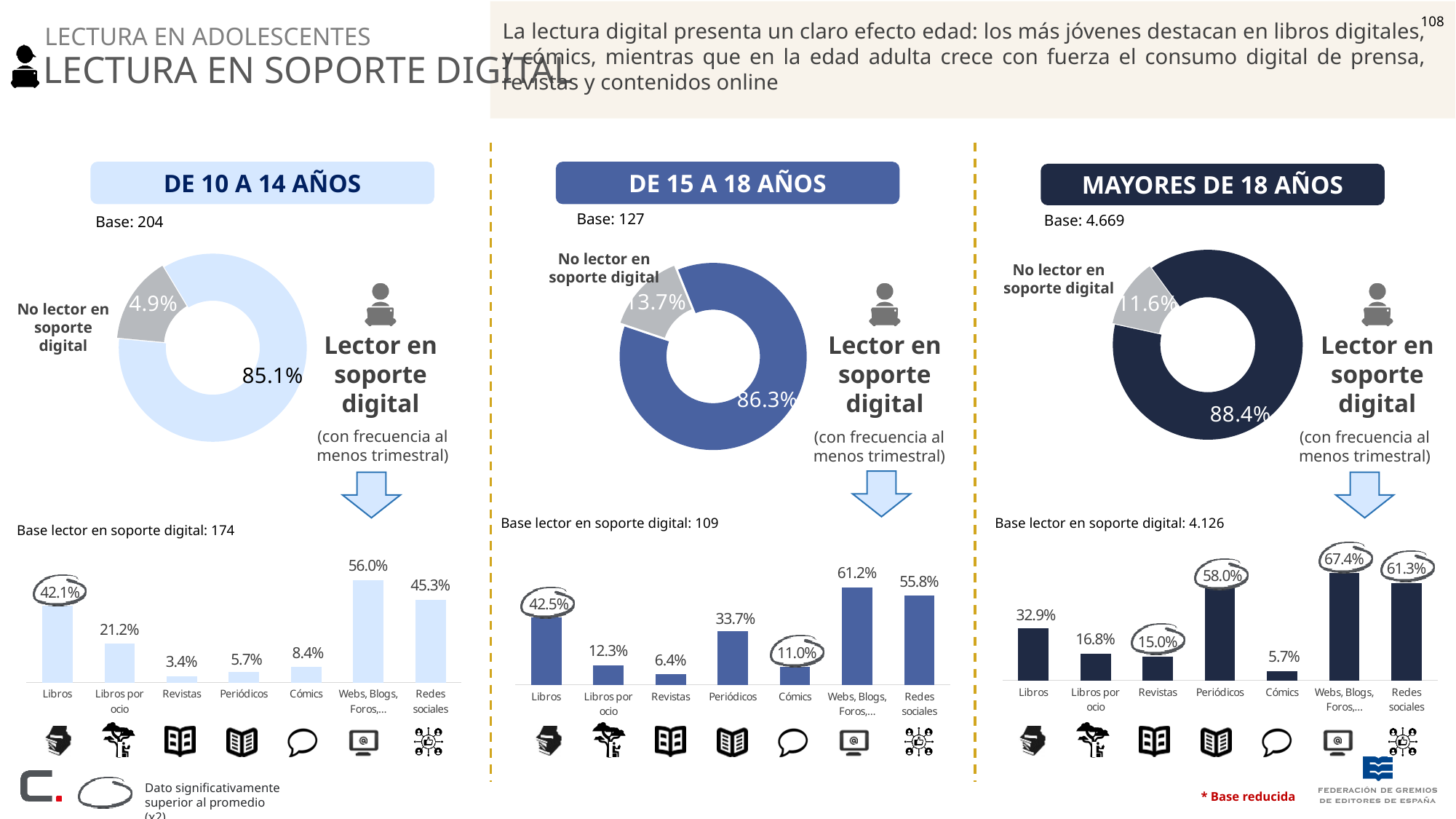
In the bar chart for 'MAYORES DE 18 AÑOS', which is larger, Libros or Periódicos? Periódicos In the donut chart for 'MAYORES DE 18 AÑOS', what share is 'Lector en soporte digital'? 88.4% In the bar chart for 'DE 15 A 18 AÑOS', which category has the highest value? Webs, Blogs, Foros,... In the bar chart for 'DE 10 A 14 AÑOS', what is the value for Webs, Blogs, Foros,...? 56.0% In the bar chart for 'MAYORES DE 18 AÑOS', what is the difference between Webs, Blogs, Foros,... and Redes sociales? 6.1% In the donut chart for 'DE 15 A 18 AÑOS', what share is 'No lector en soporte digital'? 13.7% In the bar chart for 'DE 10 A 14 AÑOS', which category has the lowest value? Revistas In the bar chart for 'MAYORES DE 18 AÑOS', what is the value for Cómics? 5.7% In the donut chart for 'DE 10 A 14 AÑOS', what share is 'Lector en soporte digital'? 85.1% What kind of chart is used at the top of each age-group column on the slide? Donut chart In the bar chart for 'DE 15 A 18 AÑOS', what is the value for Periódicos? 33.7% How many categories does the bar chart for 'DE 15 A 18 AÑOS' show? 7